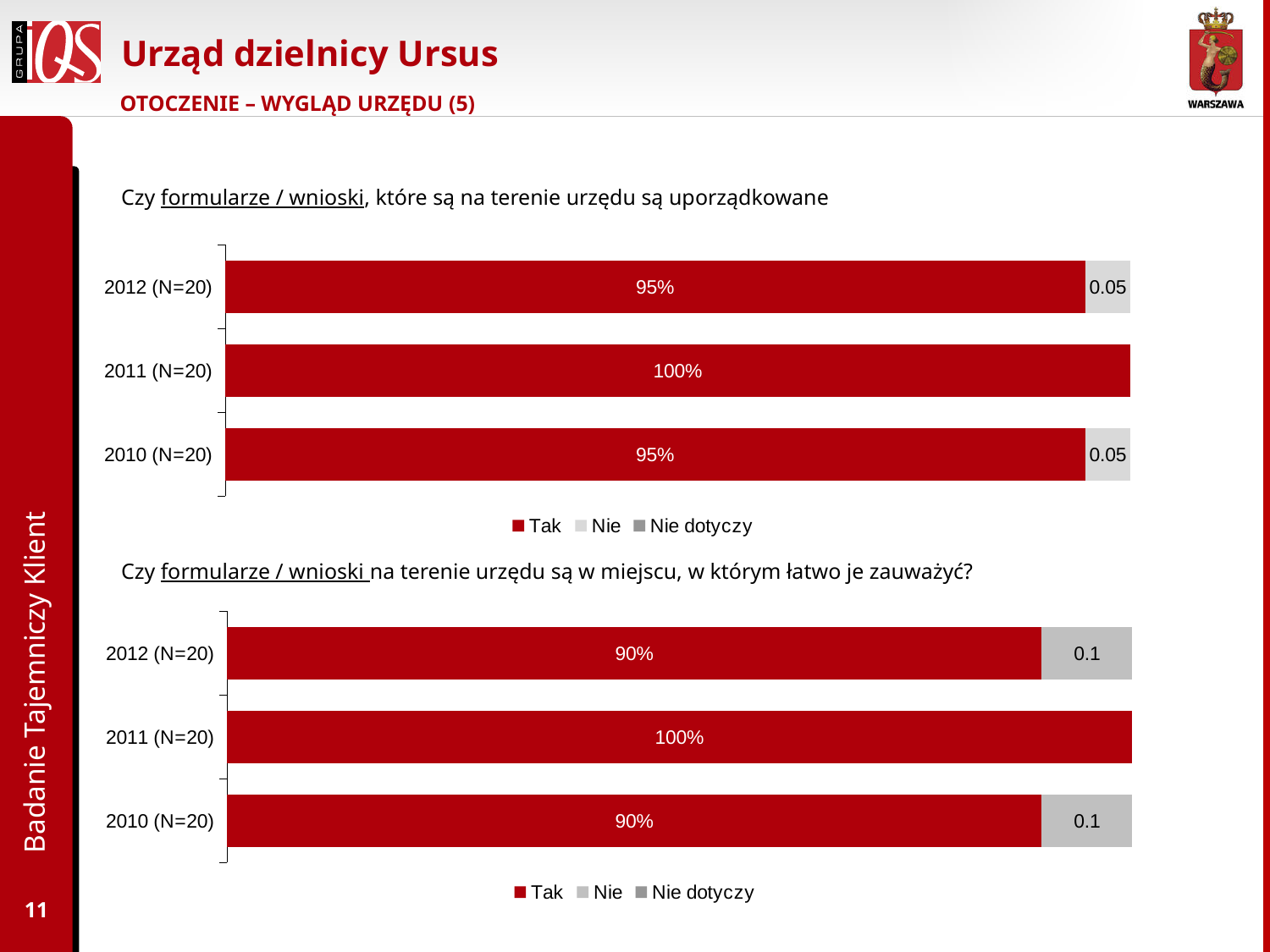
How many series does the legend of the bottom chart (formularze / wnioski łatwo je zauważyć) list? 3 In the bottom chart (formularze / wnioski łatwo je zauważyć), what value is printed on the grey segment for 2012 (N=20)? 0.1 What type of chart is the top chart (formularze / wnioski uporządkowane)? stacked bar chart In the bottom chart (formularze / wnioski łatwo je zauważyć), which year has the highest Tak value? 2011 (N=20) How many year categories are shown in the top chart (formularze / wnioski uporządkowane)? 3 In the top chart (formularze / wnioski uporządkowane), what is the Tak value for 2012 (N=20)? 95% In the bottom chart (formularze / wnioski łatwo je zauważyć), what is the Tak value for 2010 (N=20)? 90% In the top chart (formularze / wnioski uporządkowane), what is the difference between the Tak value for 2011 and the Tak value for 2012? 5% In the bottom chart (formularze / wnioski łatwo je zauważyć), is the Tak value for 2012 larger or smaller than the Tak value for 2011? smaller What are the legend entries of the top chart (formularze / wnioski uporządkowane)? Tak, Nie, Nie dotyczy In the top chart (formularze / wnioski uporządkowane), what is the Tak value for 2011 (N=20)? 100% In the top chart (formularze / wnioski uporządkowane), what value is printed on the grey segment for 2010 (N=20)? 0.05